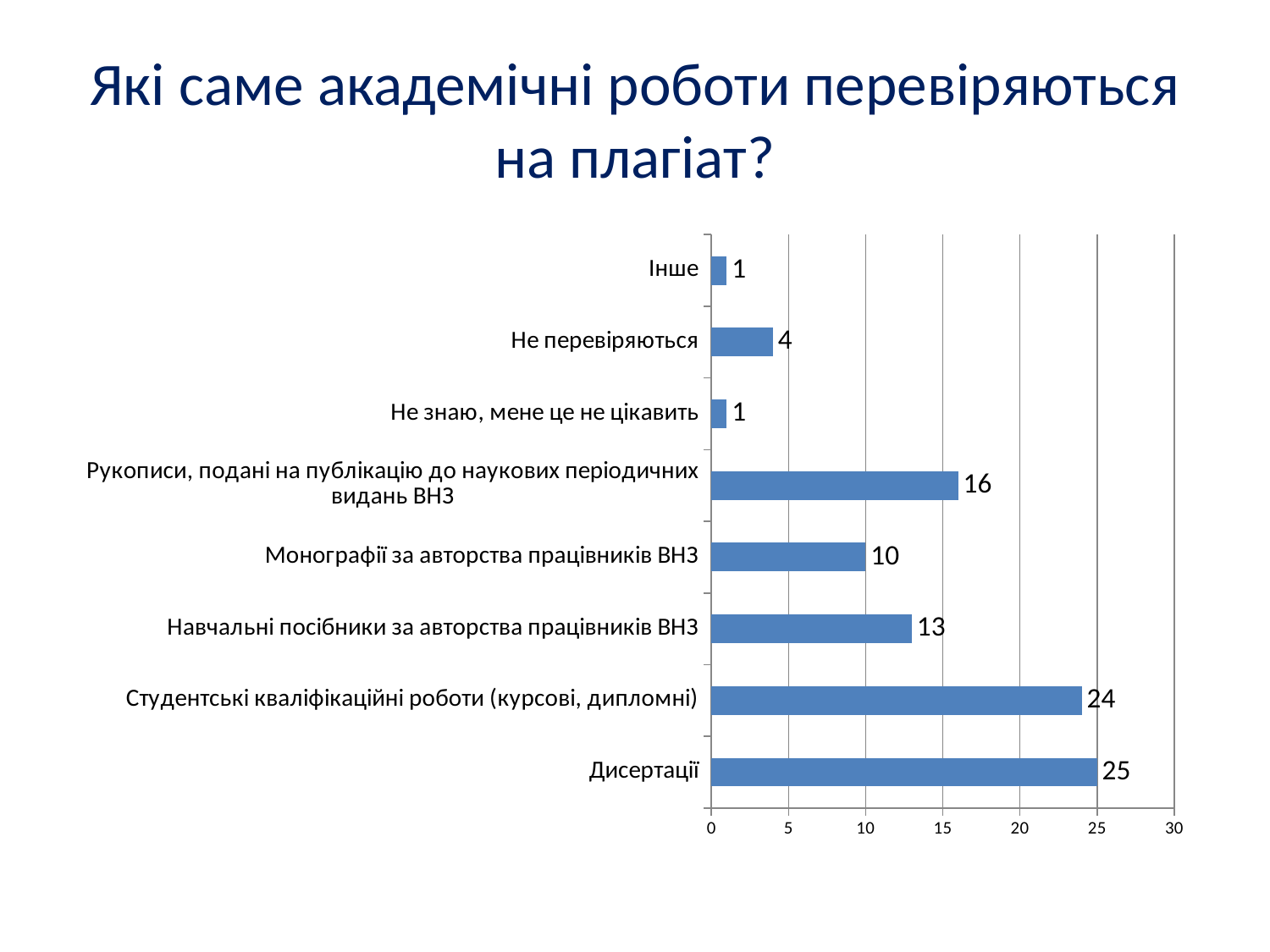
What is the difference between the values for Дисертації and Студентські кваліфікаційні роботи (курсові, дипломні)? 1 What is the value for Не перевіряються? 4 Which category has the highest value? Дисертації What is the maximum value shown on the horizontal axis? 30 What is the title of the slide? Які саме академічні роботи перевіряються на плагіат? How many categories are shown in the chart? 8 Which is larger, the value for Навчальні посібники за авторства працівників ВНЗ or the value for Монографії за авторства працівників ВНЗ? Навчальні посібники за авторства працівників ВНЗ What is the value for Монографії за авторства працівників ВНЗ? 10 Is the value for Рукописи, подані на публікацію до наукових періодичних видань ВНЗ greater or less than 15? greater What is the value for Дисертації? 25 What kind of chart is shown on the slide? bar chart What is the difference between the values for Рукописи, подані на публікацію до наукових періодичних видань ВНЗ and Навчальні посібники за авторства працівників ВНЗ? 3